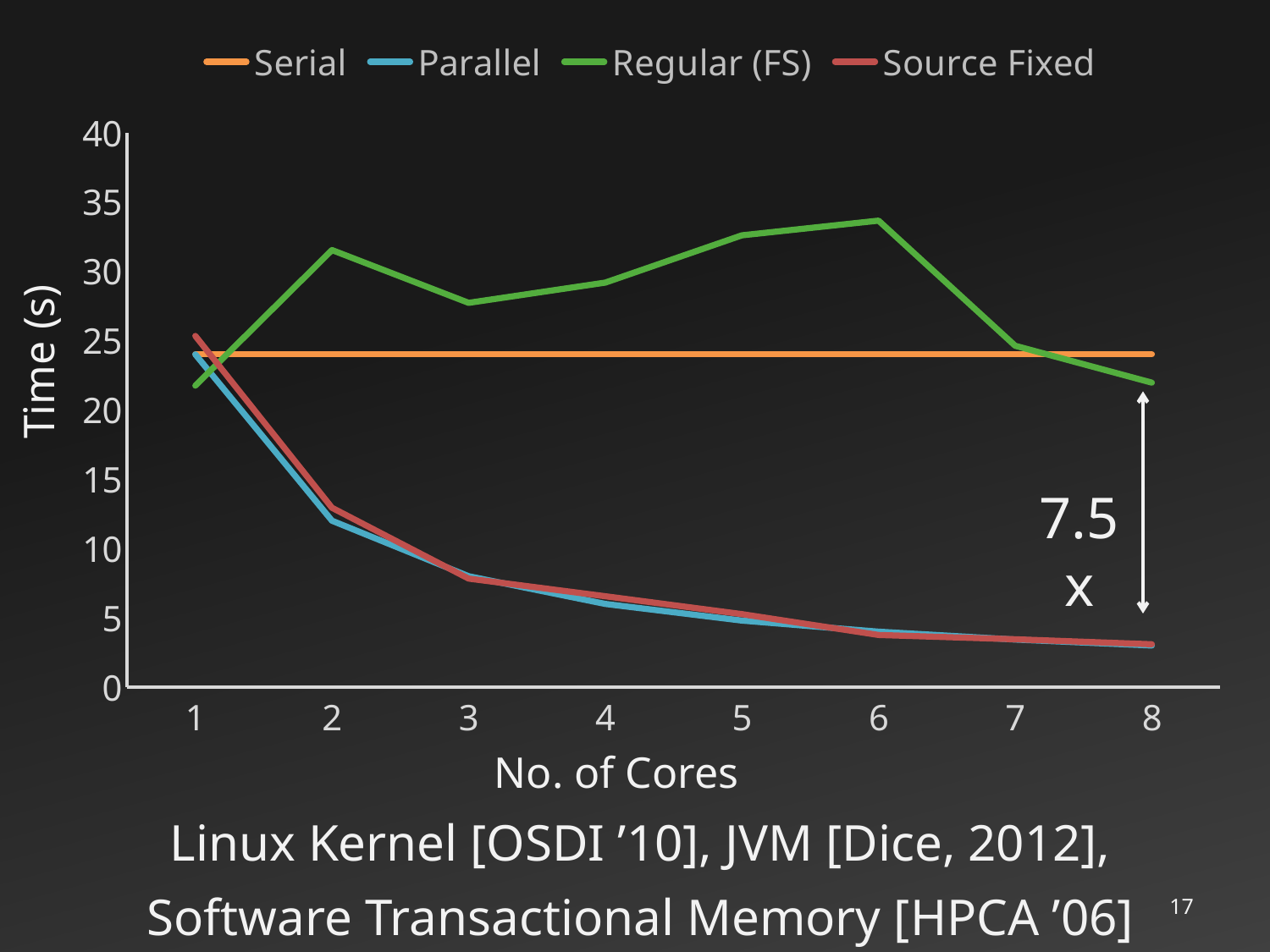
At which number of cores does the Regular (FS) series reach its highest value? 6 What is the label of the y axis? Time (s) What is the label of the x axis? No. of Cores What kind of chart is shown on the slide? line chart Does the Parallel series rise or fall as the number of cores increases? fall At 2 cores, which is higher: Regular (FS) or Serial? Regular (FS) At which number of cores is the Parallel series lowest? 8 How many series does the legend list? 4 Is the Source Fixed value at 2 cores greater or less than 10? greater Is the Regular (FS) value at 6 cores greater or less than 30? greater Is the Parallel value at 8 cores greater or less than 5? less How many values of No. of Cores are plotted along the x axis? 8